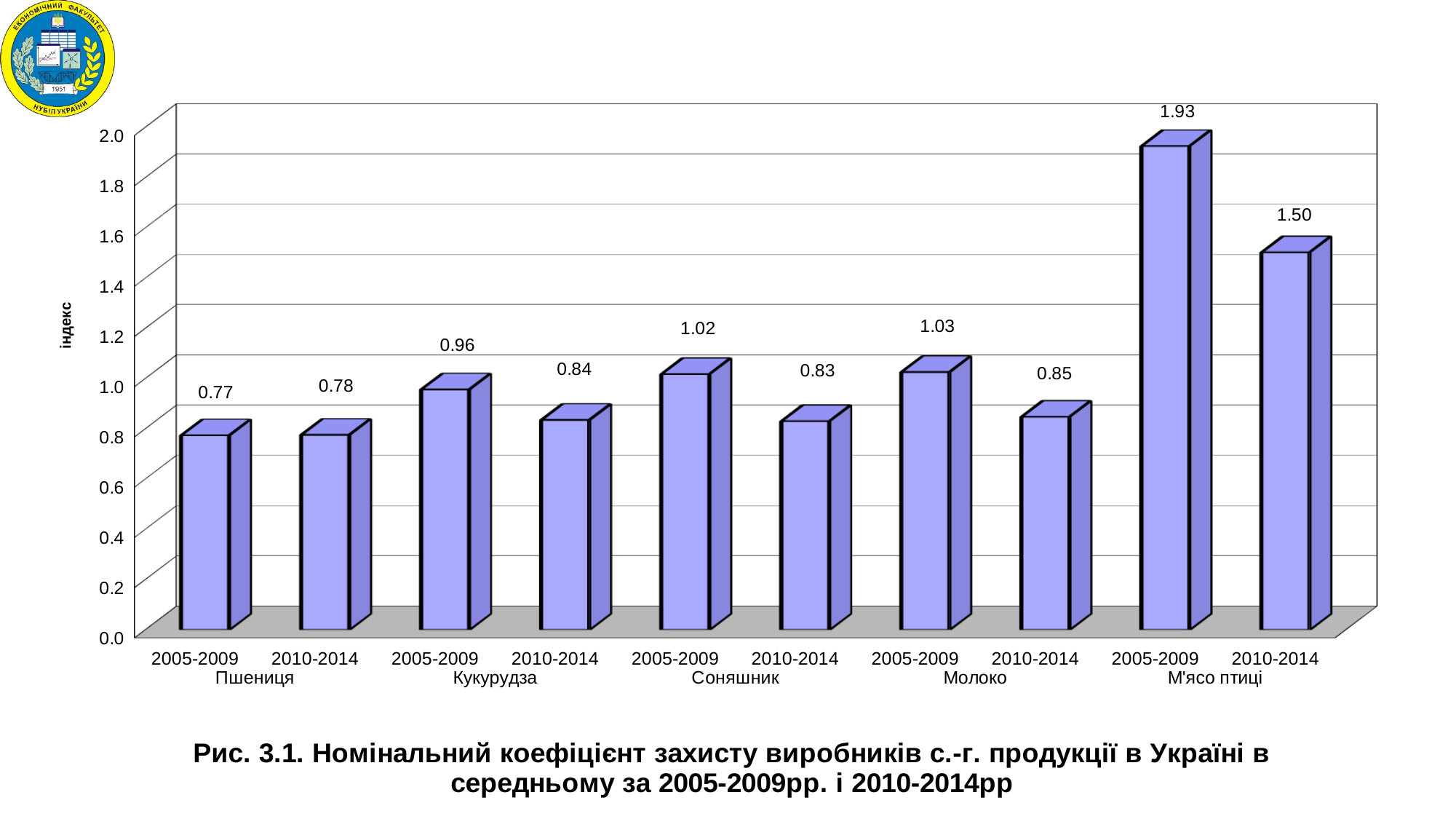
Which bar has the highest value? М'ясо птиці 2005-2009 Which is larger: Соняшник 2005-2009 or Молоко 2005-2009? Молоко 2005-2009 What is the difference between the М'ясо птиці values for 2005-2009 and 2010-2014? 0.43 What is the value for М'ясо птиці in 2010-2014? 1.50 What is the difference between the Кукурудза values for 2005-2009 and 2010-2014? 0.12 What is the label on the vertical axis? індекс What is the value for Кукурудза in 2010-2014? 0.84 What kind of chart is shown? bar chart Which bar has the lowest value? Пшениця 2005-2009 How many bars are plotted on the chart? 10 What is the value for Пшениця in 2005-2009? 0.77 Is the value for Соняшник 2010-2014 greater or less than 1.0? less